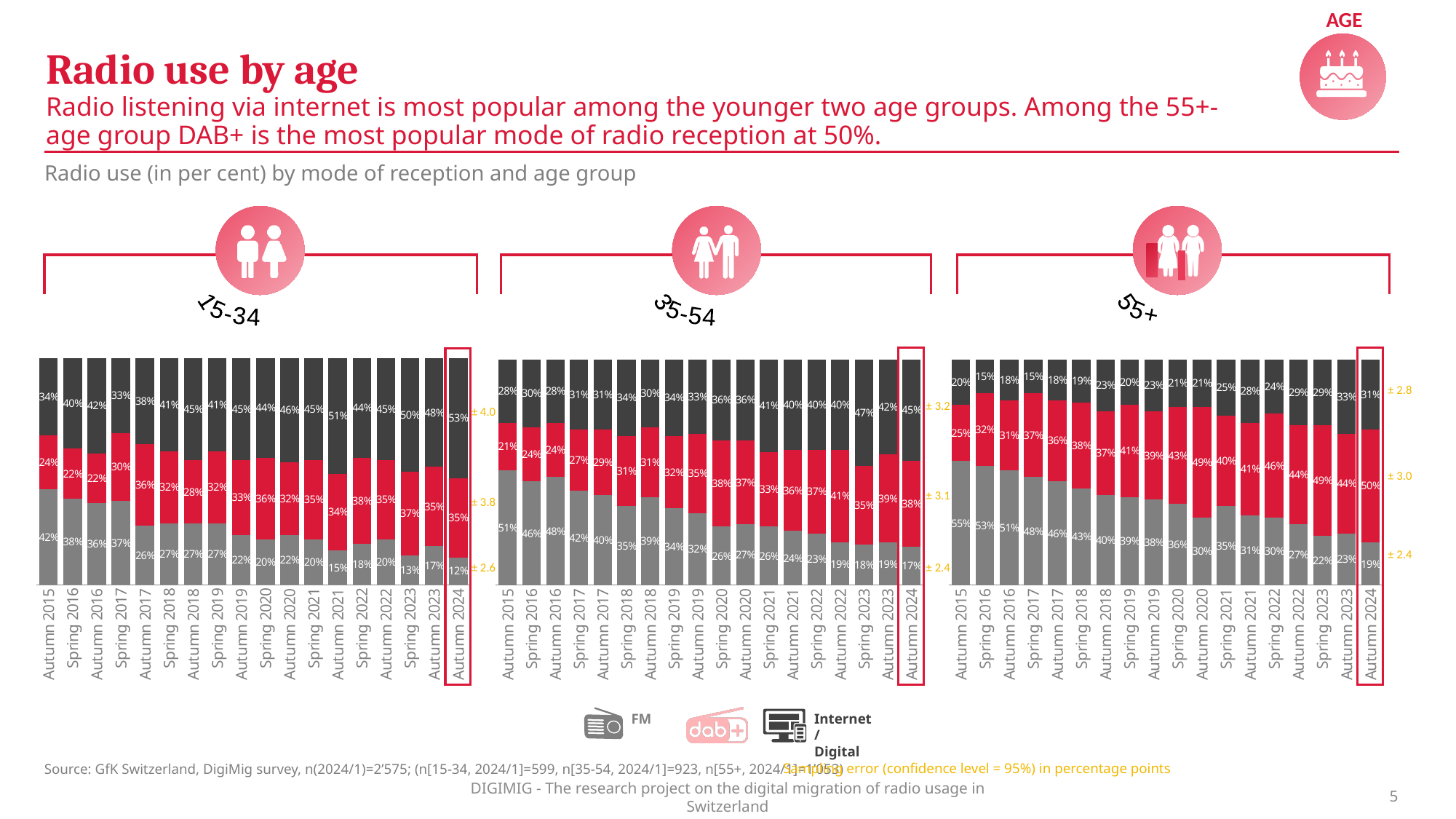
In the 15-34 chart, what is the Internet/Digital share for Autumn 2024? 53% What type of chart is used to show radio use by age group? Stacked bar chart In the 55+ chart, which is larger in Autumn 2024: the FM share or the Internet/Digital share? Internet/Digital In the 15-34 chart, what is the FM share for Autumn 2015? 42% In the 15-34 chart, which survey wave has the lowest FM share? Autumn 2024 In the 35-54 chart, which survey wave has the highest FM share? Autumn 2015 How many survey waves (bars) are shown in each chart? 18 In the 55+ chart, what is the DAB+ share for Autumn 2024? 50% In the 15-34 chart, what is the difference between the Internet/Digital share in Autumn 2024 and in Autumn 2015? 19 percentage points In the 55+ chart, what is the FM share for Autumn 2015? 55% In the 35-54 chart, what is the DAB+ share for Autumn 2024? 38% How many modes of reception does the legend list? 3